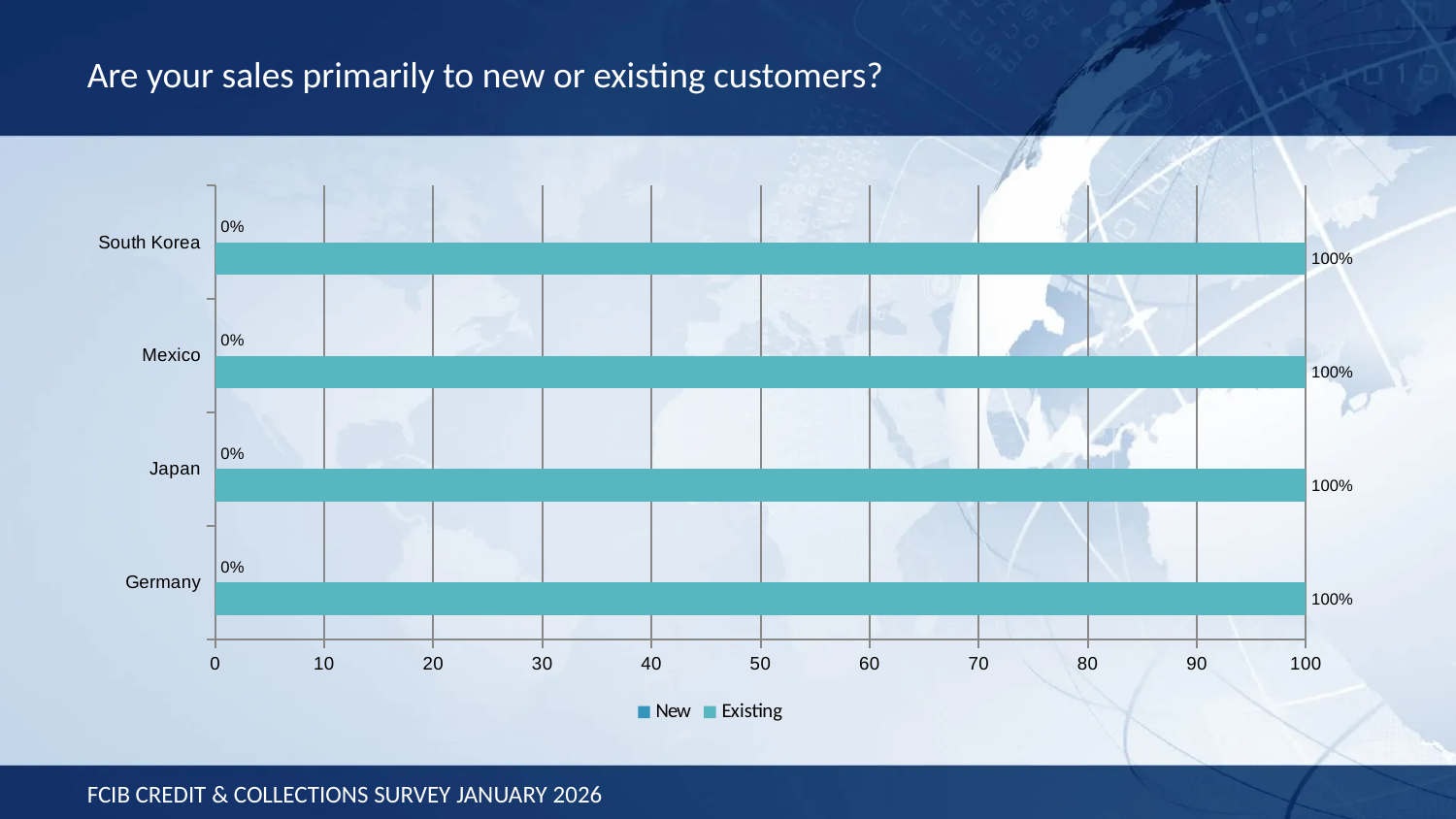
Is the Existing value for South Korea greater or less than 50? greater What is the title of the chart? Are your sales primarily to new or existing customers? How many series does the legend list? 2 What are the two series named in the legend? New and Existing What kind of chart is shown on the slide? Bar chart How many countries are shown on the chart? 4 What is the value for Existing customers in Germany? 100% What is the difference between the Existing and New values for Germany? 100% What is the value for New customers in Mexico? 0% What is the value for Existing customers in Japan? 100% Which is larger for Mexico, the New value or the Existing value? Existing What is the value for New customers in South Korea? 0%